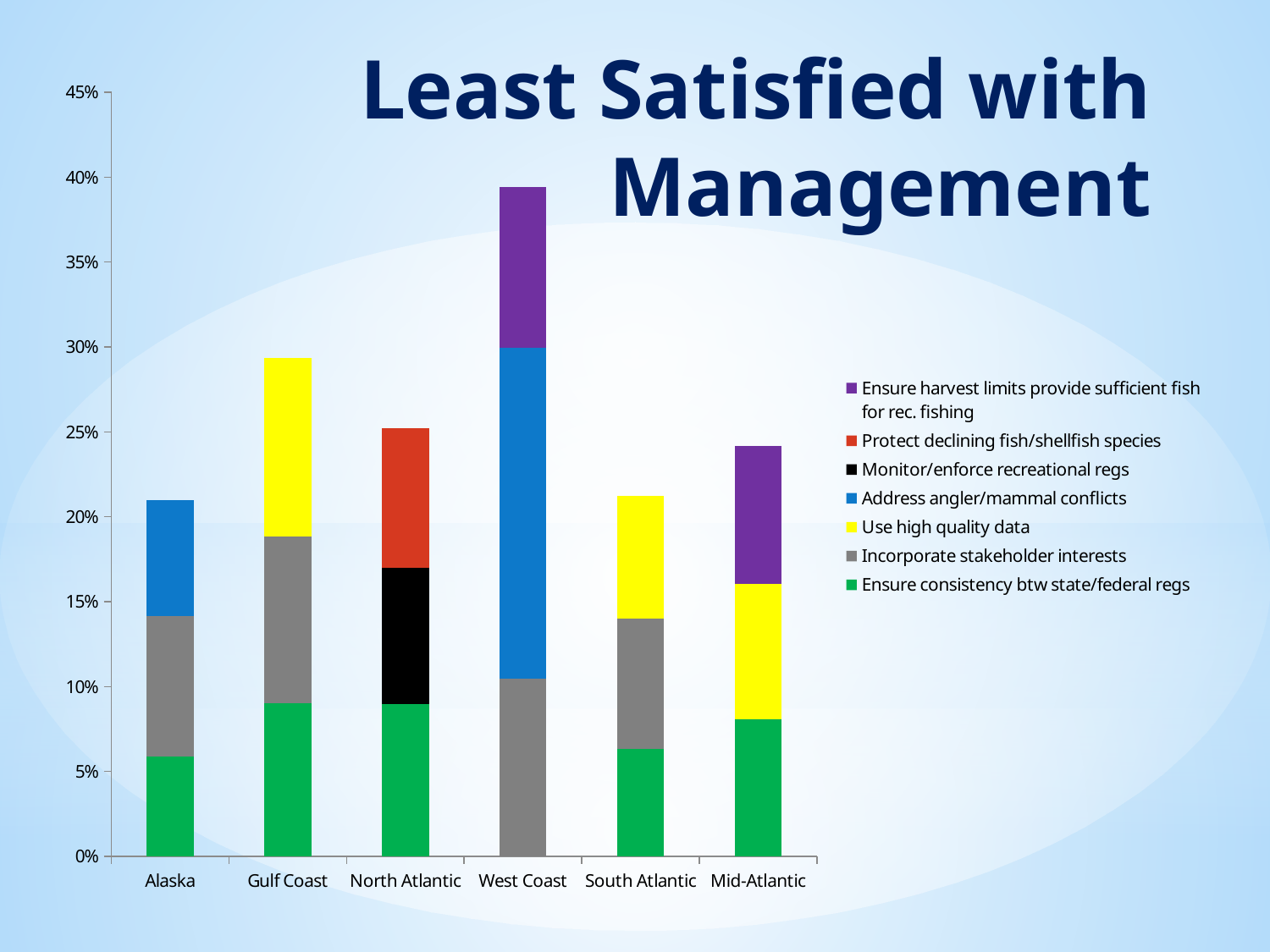
Which region has the tallest stacked bar? West Coast How many series does the legend list? 7 What is the title of the chart? Least Satisfied with Management Which region's bar includes the 'Monitor/enforce recreational regs' (black) segment? North Atlantic Is the total for Gulf Coast greater or less than 25%? greater Which has the taller stacked bar, Gulf Coast or Mid-Atlantic? Gulf Coast Is the total for Alaska greater or less than 25%? less Is the total for West Coast greater or less than 35%? greater What kind of chart is shown on the slide? Stacked bar chart How many regions are shown on the x axis? 6 Which has the taller stacked bar, West Coast or Gulf Coast? West Coast